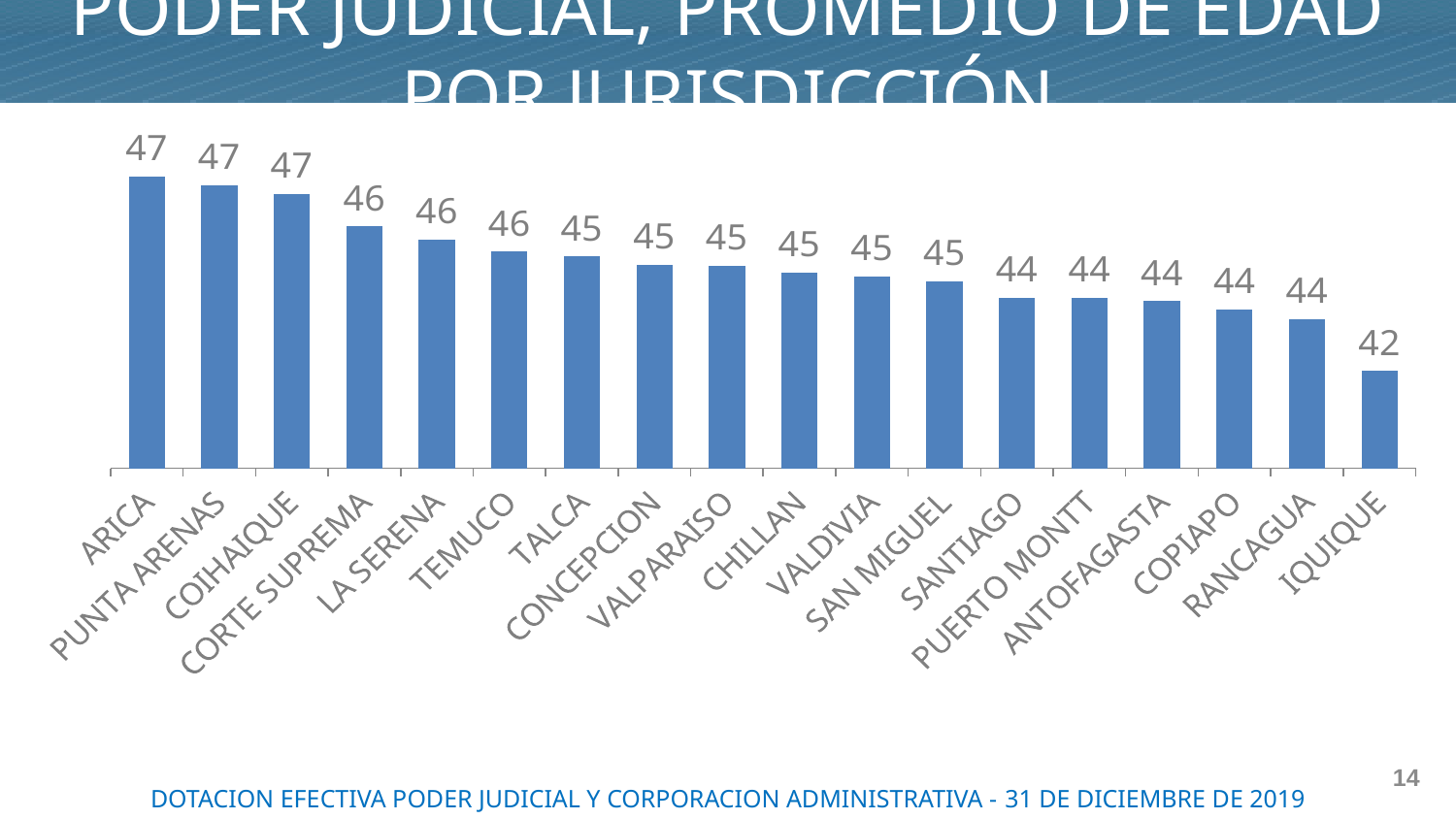
Which is larger, the value for COIHAIQUE or the value for COPIAPO? COIHAIQUE What is the difference between the values for LA SERENA and RANCAGUA? 2 What is the value for SANTIAGO? 44 What kind of chart is shown on the slide? Bar chart What is the value for IQUIQUE? 42 Which jurisdiction has the lowest value? IQUIQUE Do the values generally rise or fall from left to right along the x axis? Fall What is the value for TALCA? 45 What is the difference between the values for ARICA and IQUIQUE? 5 Which is larger, the value for VALDIVIA or the value for IQUIQUE? VALDIVIA How many jurisdictions are shown in the chart? 18 What is the value for CORTE SUPREMA? 46